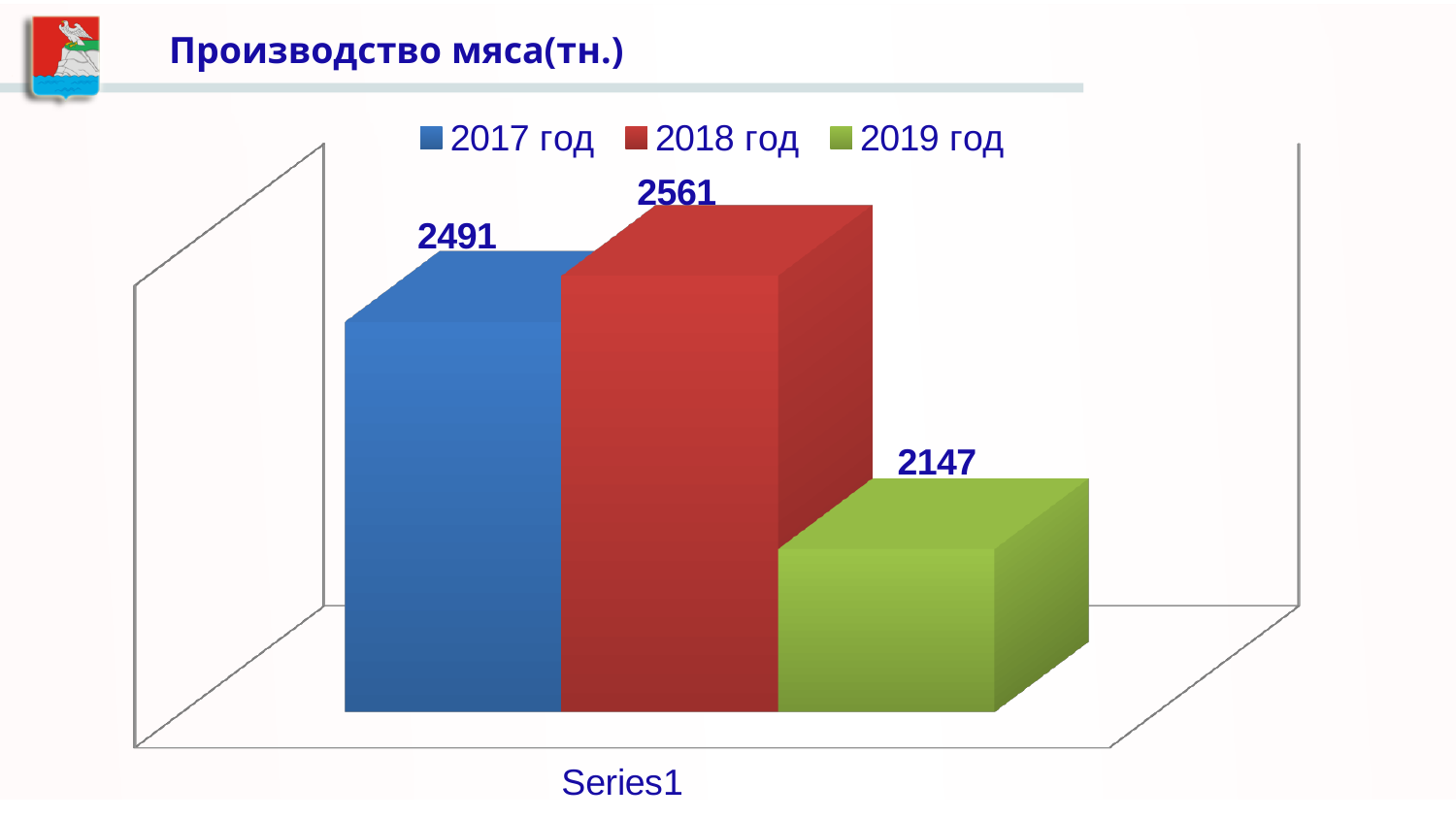
What kind of chart is shown on the slide? bar chart Which year has the lowest meat production? 2019 год What is the value for 2019 год? 2147 Which is larger, the value for 2017 год or the value for 2019 год? 2017 год What is the value for 2017 год? 2491 What colour is the bar for 2019 год? green What is the difference between the values for 2018 год and 2017 год? 70 Which year has the highest meat production? 2018 год What is the value for 2018 год? 2561 What is the title of the chart? Производство мяса(тн.) How many series does the legend list? 3 What is the difference between the values for 2018 год and 2019 год? 414